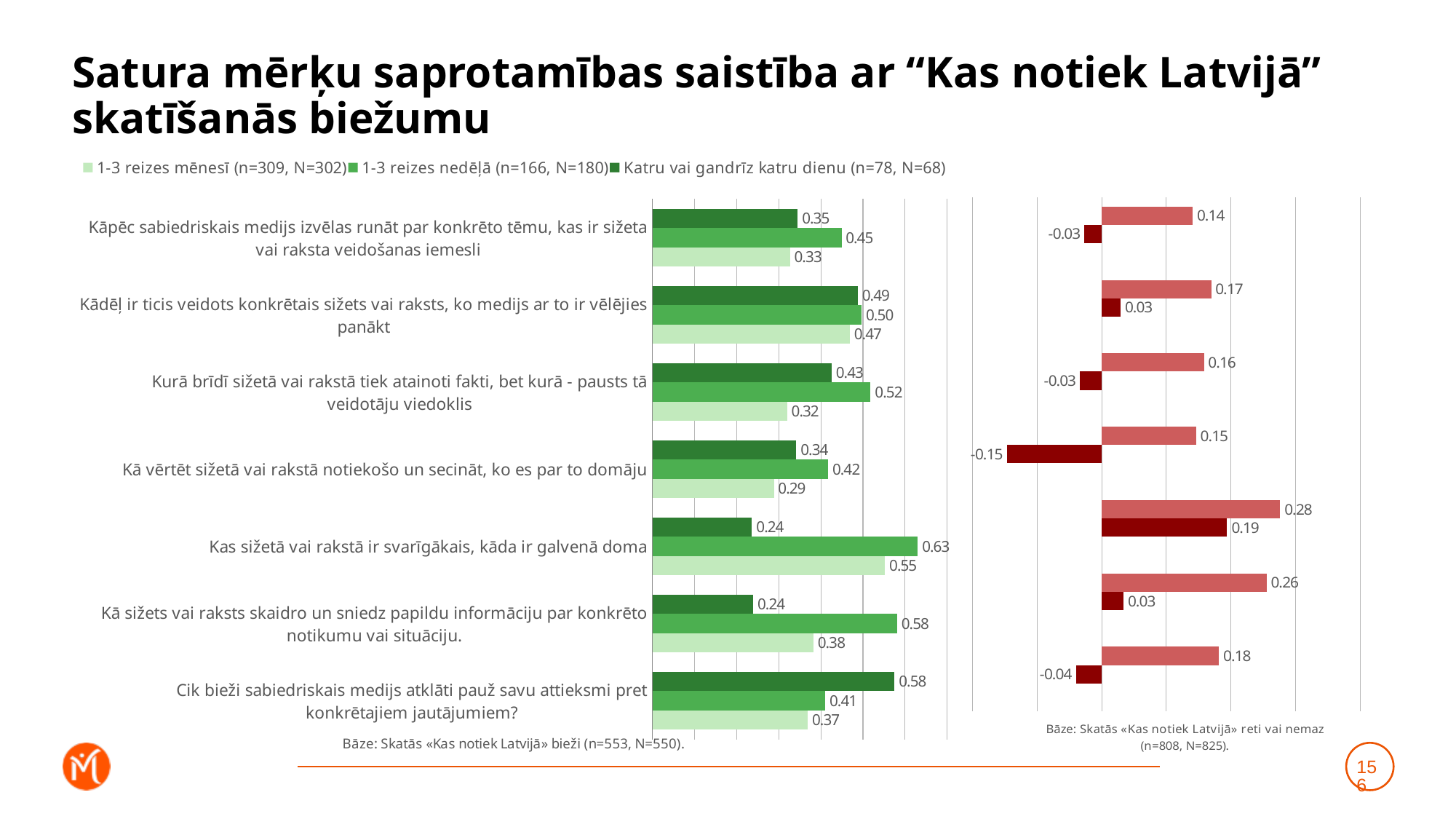
In the left (green) chart, what is the difference between the '1-3 reizes nedēļā' and 'Katru vai gandrīz katru dienu' values for 'Kas sižetā vai rakstā ir svarīgākais, kāda ir galvenā doma'? 0.39 In the left (green) chart, what is the value for '1-3 reizes mēnesī' for 'Kā vērtēt sižetā vai rakstā notiekošo un secināt, ko es par to domāju'? 0.29 In the left (green) chart, what is the value for '1-3 reizes nedēļā' for 'Kas sižetā vai rakstā ir svarīgākais, kāda ir galvenā doma'? 0.63 In the right (red) chart, what is the highest value shown? 0.28 In the left (green) chart, which category has the highest value for 'Katru vai gandrīz katru dienu'? Cik bieži sabiedriskais medijs atklāti pauž savu attieksmi pret konkrētajiem jautājumiem? How many categories are shown in the left (green) chart? 7 How many series does the legend list for the left (green) chart? 3 In the left (green) chart, which category has the lowest value for '1-3 reizes mēnesī'? Kā vērtēt sižetā vai rakstā notiekošo un secināt, ko es par to domāju What kind of chart is the left (green) chart? Bar chart In the right (red) chart, what is the lowest value shown? -0.15 In the left (green) chart, for 'Kā sižets vai raksts skaidro un sniedz papildu informāciju par konkrēto notikumu vai situāciju.', which is larger: '1-3 reizes nedēļā' or '1-3 reizes mēnesī'? 1-3 reizes nedēļā In the left (green) chart, what is the value for 'Katru vai gandrīz katru dienu' for 'Kas sižetā vai rakstā ir svarīgākais, kāda ir galvenā doma'? 0.24